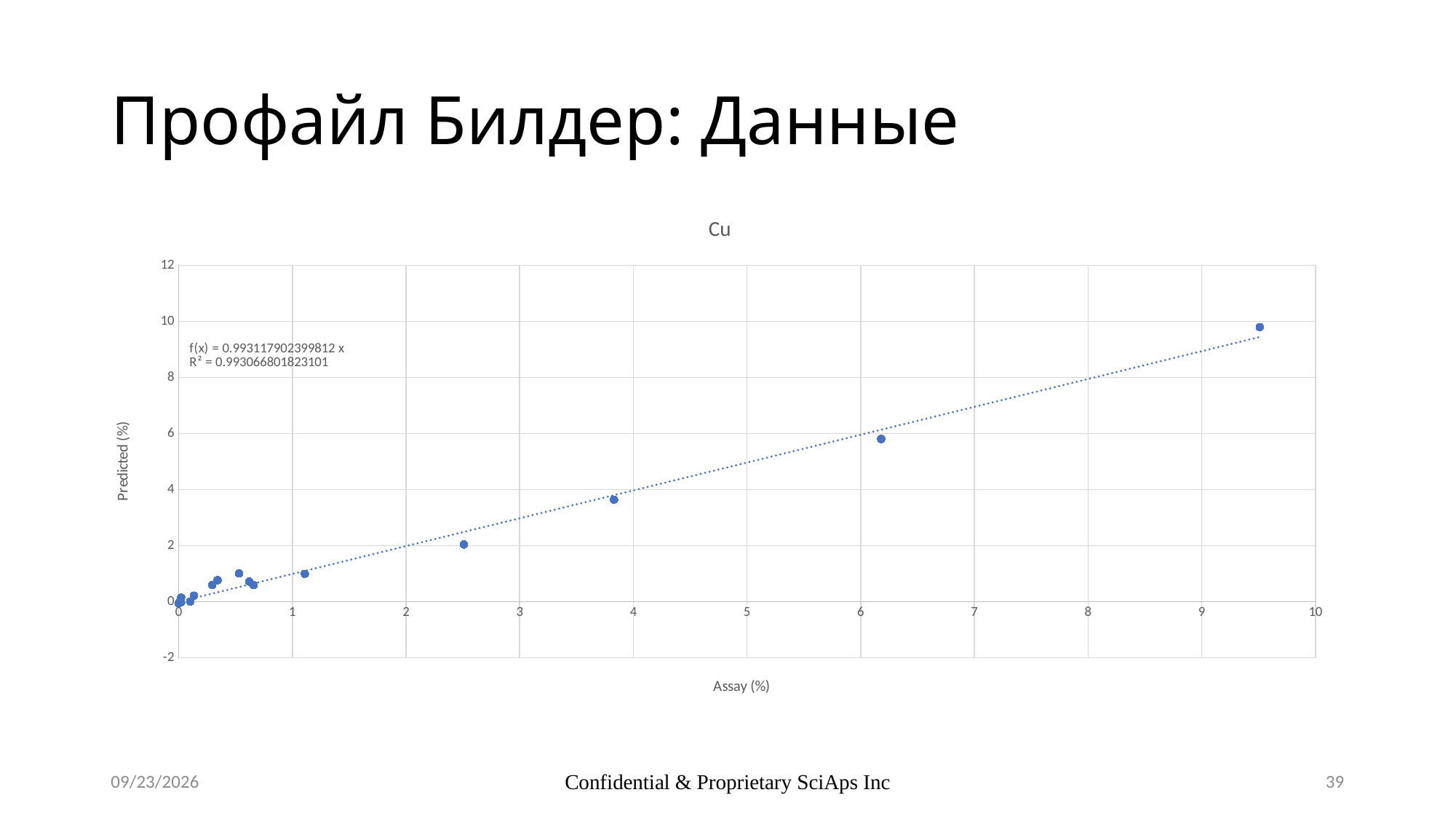
Is the Predicted (%) value for the point with the highest Assay (%) greater or less than 8? greater Is the Predicted (%) value for the point near Assay 3.8% greater or less than 2? greater Is the Predicted (%) value for the point near Assay 1.1% greater or less than 2? less Which point has the higher Predicted (%) value: the one near Assay 6.2% or the one near Assay 9.5%? the one near Assay 9.5% Do the Predicted (%) values rise or fall as Assay (%) increases along the x axis? rise What is the title of the chart? Cu What kind of chart is shown on the slide? scatter chart What are the x-axis and y-axis labels of the chart? Assay (%) and Predicted (%) What is the trendline equation printed on the chart? f(x) = 0.993117902399812 x What R² value is printed on the chart? 0.993066801823101